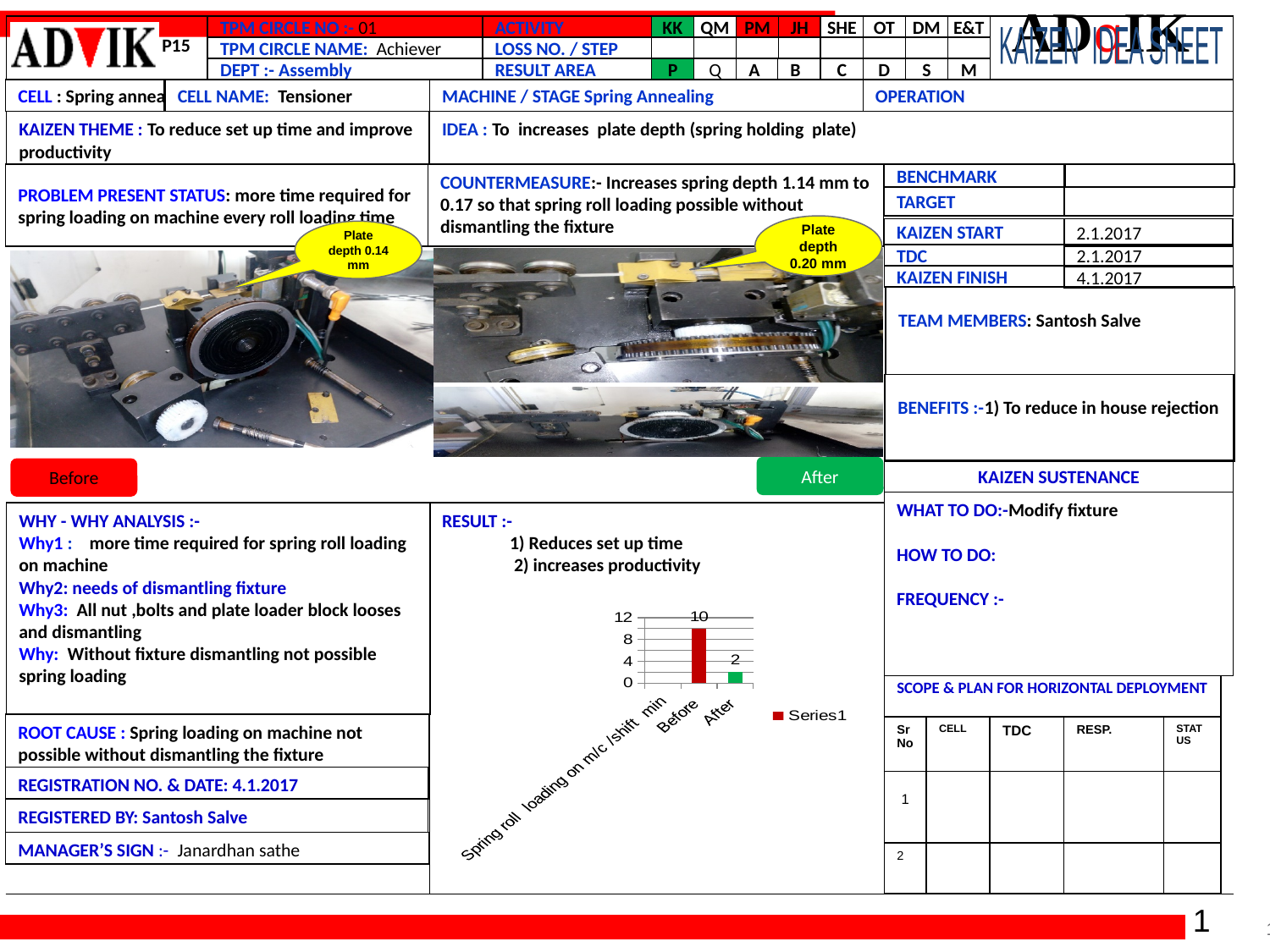
What is the difference between the Before and After values in the chart? 8 Which is larger in the chart, the Before value or the After value? Before What is the name of the series shown in the chart legend? Series1 What is the value for Before in the chart? 10 Is the value for After greater or less than 4? less How many series does the chart legend list? 1 What is the value for After in the chart? 2 Which category has the highest value in the chart? Before What kind of chart is shown on the slide? bar chart Which category has the lowest value in the chart? After Is the value for Before greater or less than 8? greater